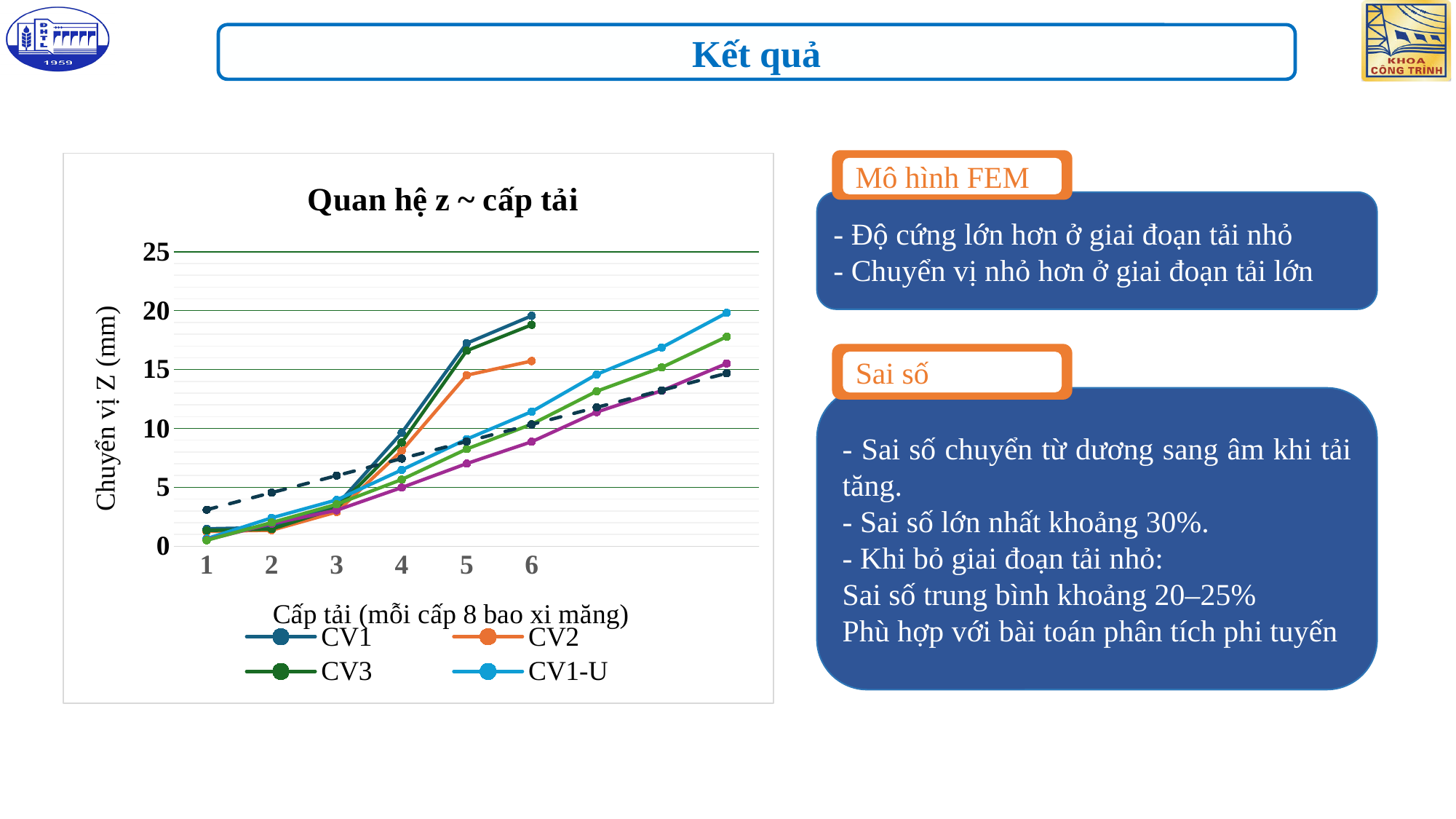
How many load levels (cấp tải) are shown on the x axis? 6 Is the value for CV1 at load level 1 greater or less than 5? less Is the value for CV1-U at load level 3 greater or less than 5? less What kind of chart is shown on the slide? line chart Is the value for CV1 at load level 6 greater or less than 15? greater How many series does the chart legend list? 4 What is the title of the chart? Quan hệ z ~ cấp tải What is the label of the vertical axis? Chuyển vị Z (mm) Does the CV1 series rise or fall as the load level increases from 1 to 6? rise At load level 6, which is larger, CV1 or CV2? CV1